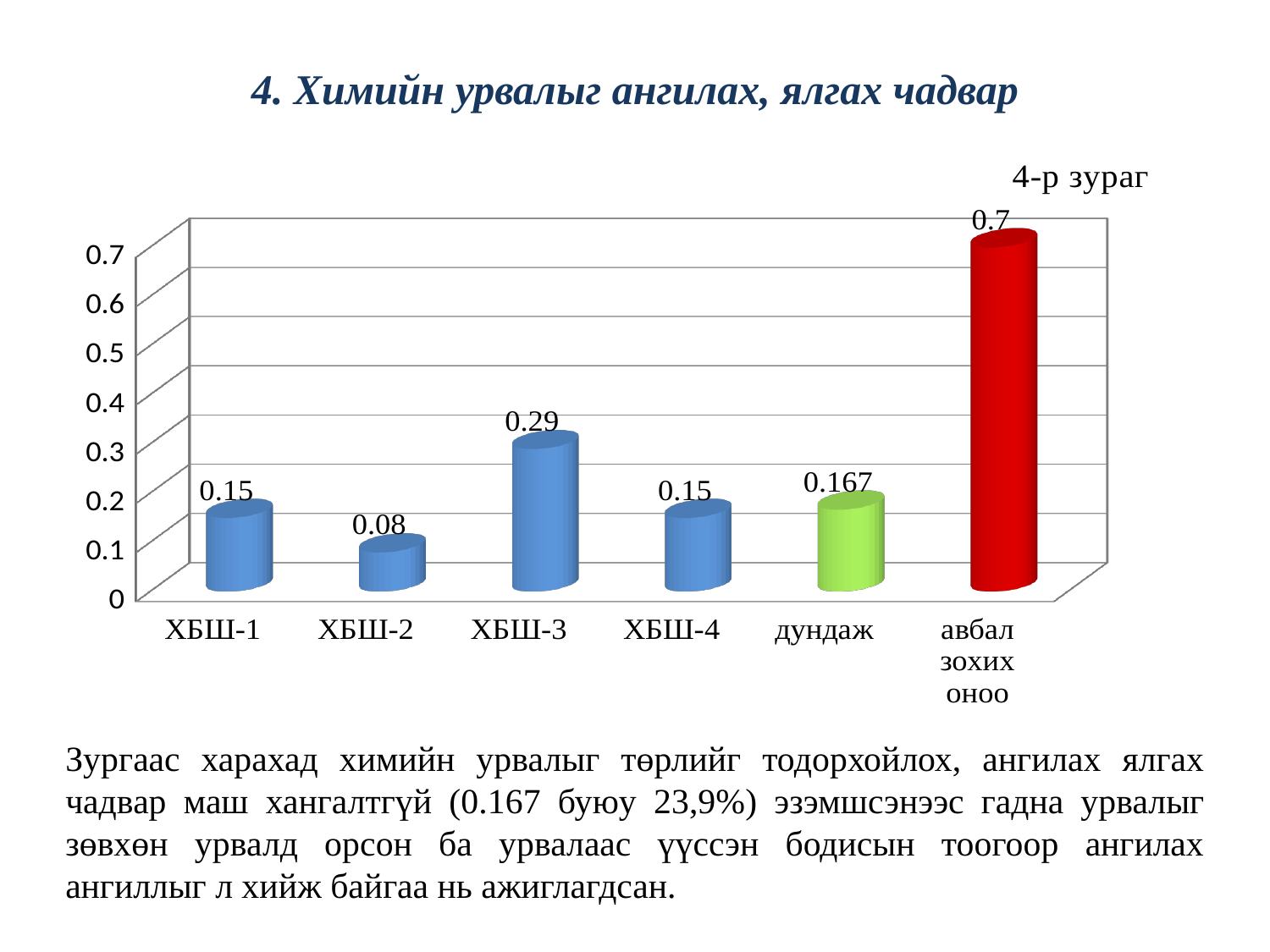
What is the value for авбал зохих оноо? 0.7 Which is larger, the value for ХБШ-3 or the value for ХБШ-4? ХБШ-3 What figure label appears above the chart on the right? 4-р зураг Which category has the lowest value? ХБШ-2 What is the value for дундаж? 0.167 How many categories are shown on the x axis? 6 What kind of chart is shown on the slide? bar chart What is the value for ХБШ-3? 0.29 What is the difference between the values for ХБШ-3 and ХБШ-2? 0.21 What is the value for ХБШ-2? 0.08 What is the difference between the values for авбал зохих оноо and дундаж? 0.533 Which category has the highest value? авбал зохих оноо